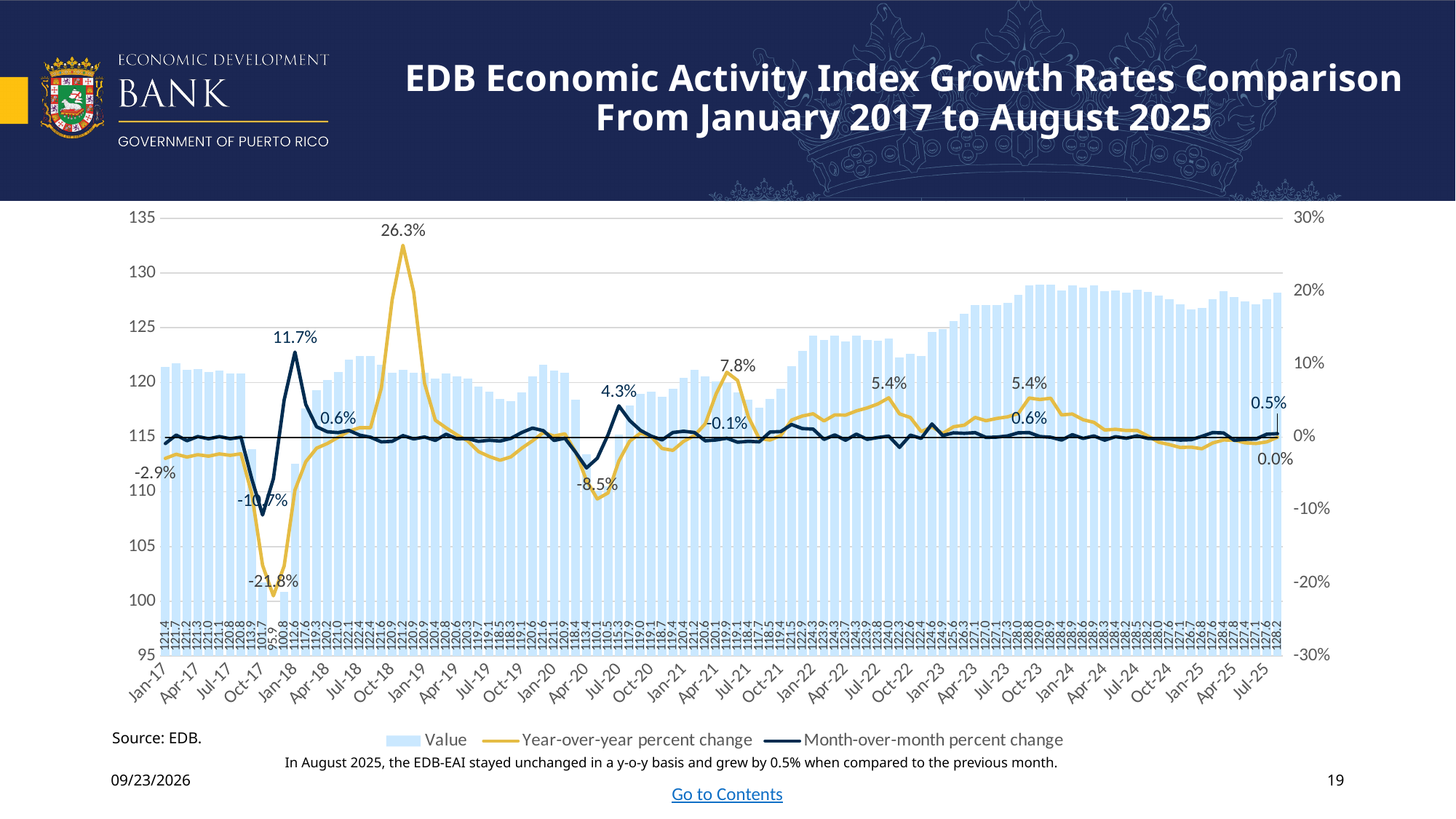
What is the difference between the highest labelled Year-over-year percent change (26.3%) and the lowest (-21.8%)? 48.1 percentage points What is the lowest labelled value of the Year-over-year percent change line? -21.8% What is the Year-over-year percent change labelled for Aug-25? 0.0% What kind of chart is shown on the slide? A combined bar and line chart What is the highest labelled value of the Year-over-year percent change line? 26.3% How many series does the legend list? 3 What is the Value (bar) for Jan-17? 121.4 Do the Value bars generally rise or fall from Jan-21 to Oct-23? rise Is the lowest Value bar, in late 2017, greater or less than 100 on the left axis? less What are the three series named in the legend? Value, Year-over-year percent change, Month-over-month percent change What is the Month-over-month percent change labelled for Aug-25? 0.5% Which is larger, the Value bar for Jan-17 (121.4) or the Value bar for Aug-25 (128.2)? Aug-25 (128.2)